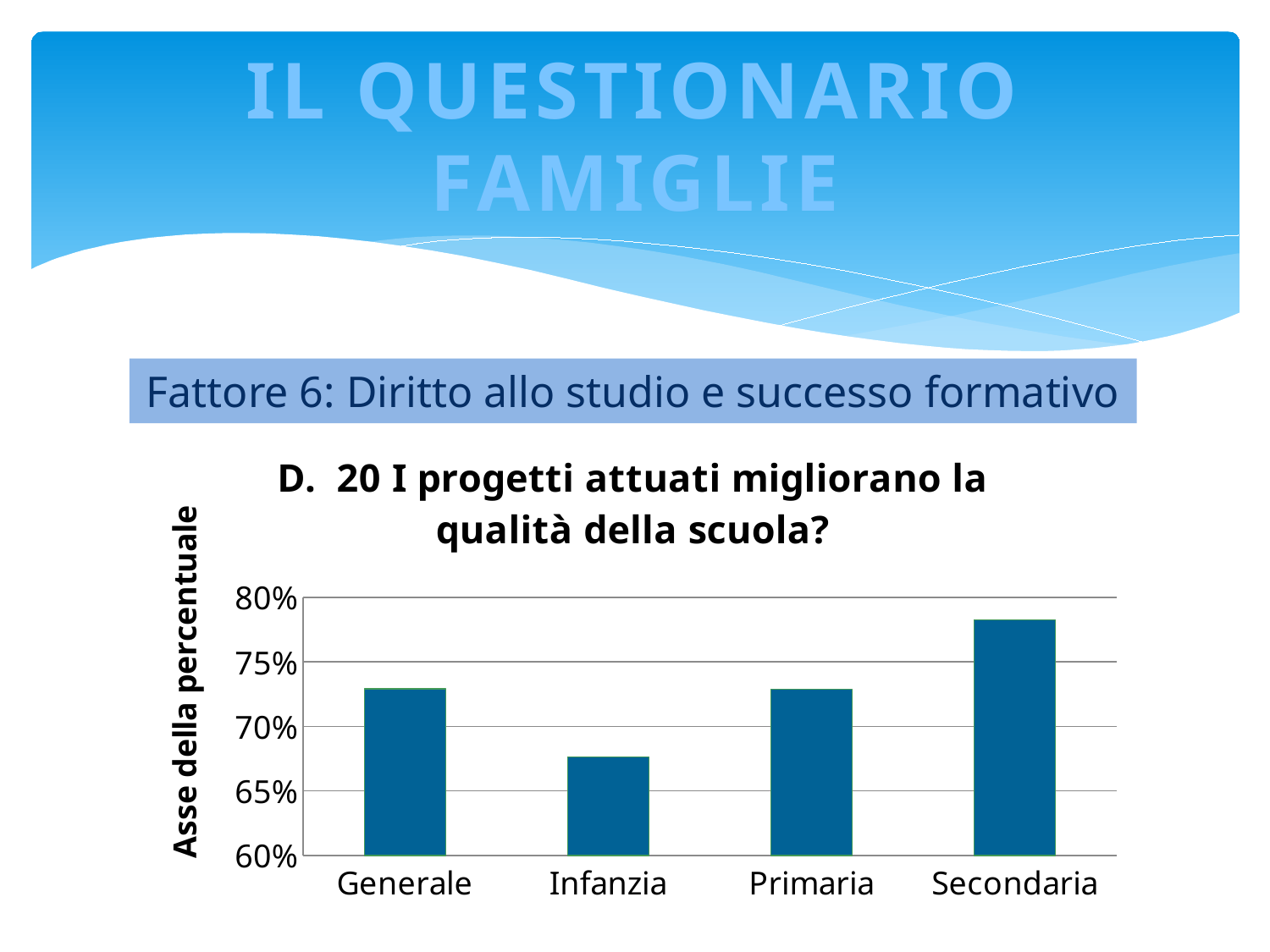
Is the value for Primaria greater or less than 75%? less How many categories are shown on the x axis of the chart? 4 Which is larger, the value for Secondaria or the value for Infanzia? Secondaria Is the value for Generale greater or less than 70%? greater Which category has the highest value in the chart? Secondaria Is the value for Infanzia greater or less than 65%? greater What kind of chart is shown on the slide? bar chart Which category has the lowest value in the chart? Infanzia What is the title of the chart? D. 20 I progetti attuati migliorano la qualità della scuola? What is the label on the vertical axis of the chart? Asse della percentuale